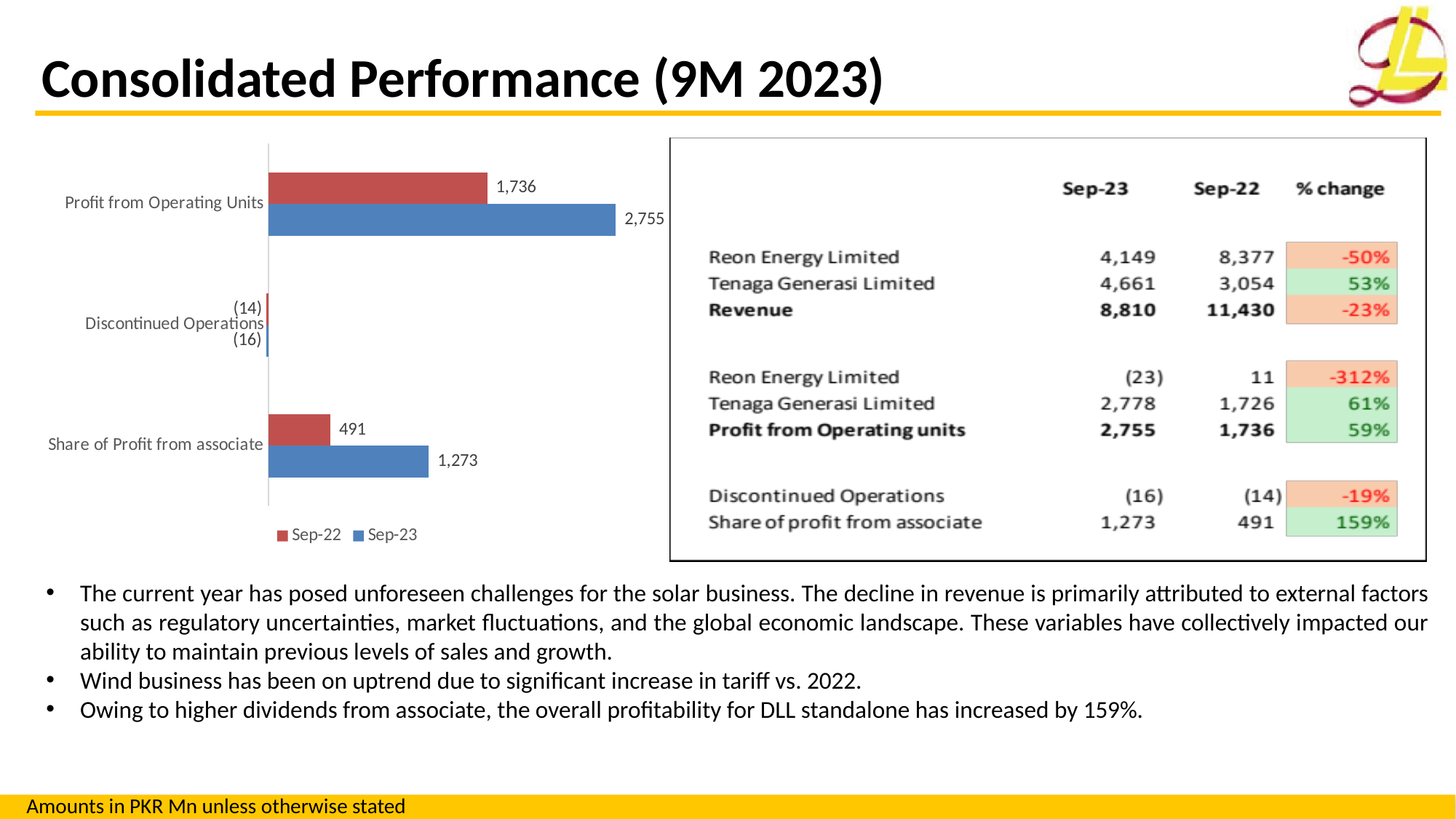
What is the Sep-22 value for Profit from Operating Units in the bar chart? 1,736 In the bar chart, which is larger for Share of Profit from associate: the Sep-22 value or the Sep-23 value? Sep-23 How many categories are shown in the bar chart? 3 What is the Sep-23 value for Profit from Operating Units in the bar chart? 2,755 How many series does the legend of the bar chart list? 2 Which category has the lowest Sep-22 value in the bar chart? Discontinued Operations Which category has the highest Sep-23 value in the bar chart? Profit from Operating Units What is the Sep-23 value for Discontinued Operations in the bar chart? (16) What is the Sep-22 value for Share of Profit from associate in the bar chart? 491 What is the difference between the Sep-23 and Sep-22 values for Profit from Operating Units in the bar chart? 1,019 What is the difference between the Sep-23 and Sep-22 values for Share of Profit from associate in the bar chart? 782 What type of chart is shown on the left of the slide? Bar chart